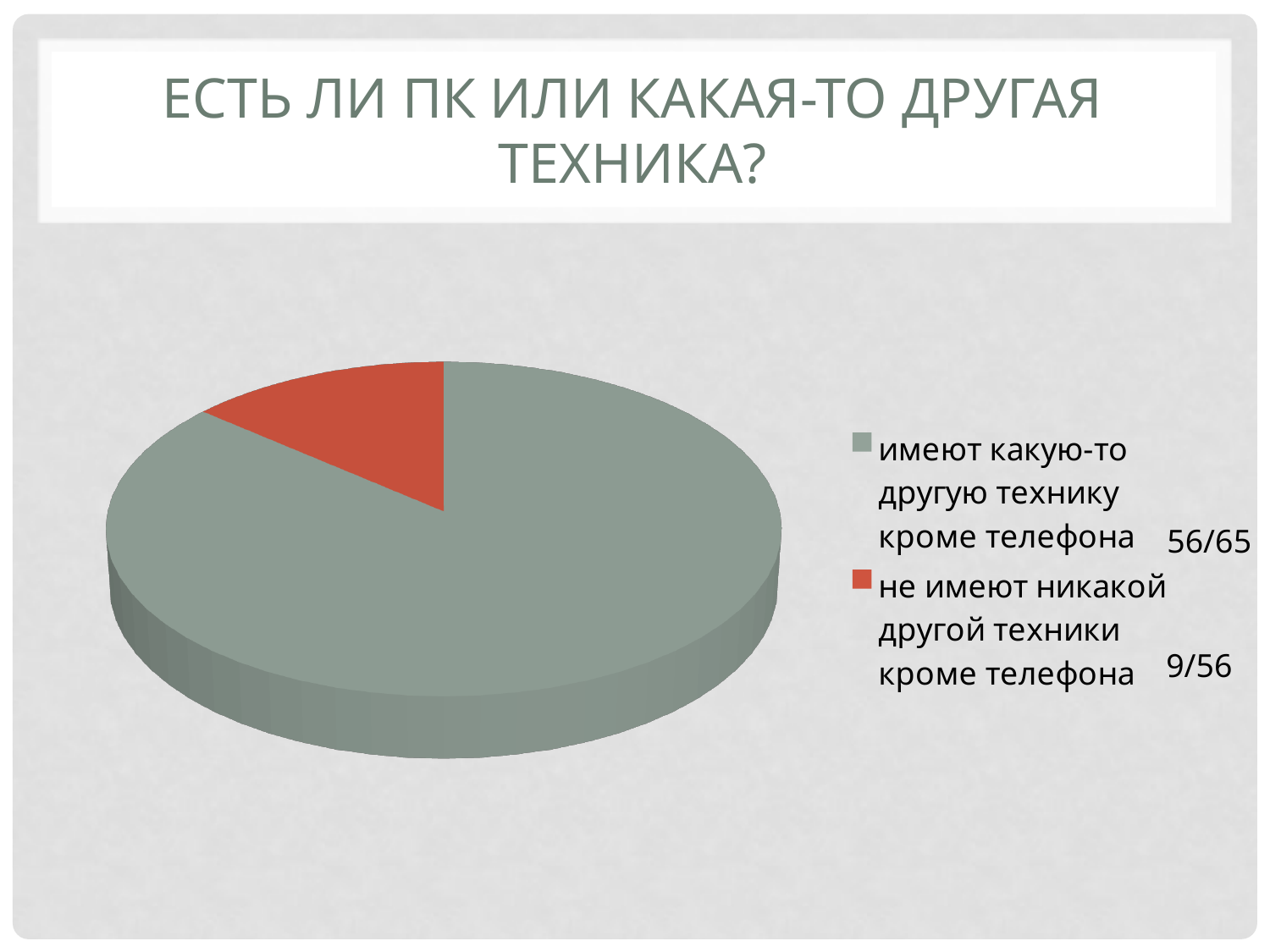
What figure is printed next to the legend entry "имеют какую-то другую технику кроме телефона"? 56/65 Which category has the smallest slice of the pie chart? не имеют никакой другой техники кроме телефона What kind of chart is shown on the slide? pie chart What figure is printed next to the legend entry "не имеют никакой другой техники кроме телефона"? 9/56 How many slices does the pie chart have? 2 What is the title of the slide containing the pie chart? ЕСТЬ ЛИ ПК ИЛИ КАКАЯ-ТО ДРУГАЯ ТЕХНИКА? How many entries does the legend of the pie chart list? 2 Which slice is larger: "имеют какую-то другую технику кроме телефона" or "не имеют никакой другой техники кроме телефона"? имеют какую-то другую технику кроме телефона Which category has the largest slice of the pie chart? имеют какую-то другую технику кроме телефона What colour is the slice for "не имеют никакой другой техники кроме телефона"? red